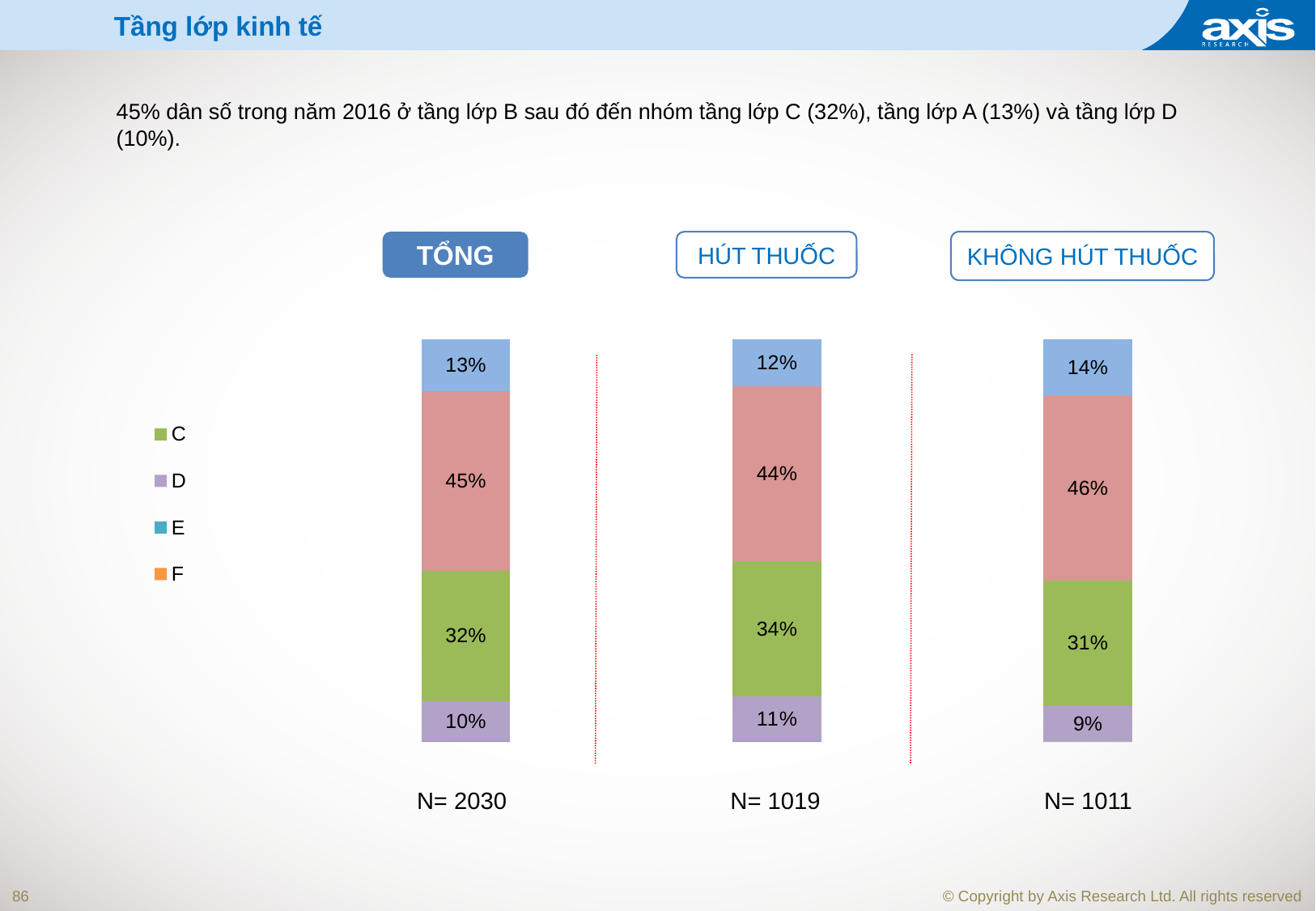
What is the difference between the pink segment in the KHÔNG HÚT THUỐC bar and the pink segment in the HÚT THUỐC bar? 2 percentage points How many entries does the legend list? 4 In the KHÔNG HÚT THUỐC bar, what is the value of the top blue segment? 14% How many stacked bars are shown on the slide? 3 In the KHÔNG HÚT THUỐC bar, what is the value of the pink segment? 46% What is the sample size shown under the HÚT THUỐC bar? N= 1019 Which segment is the largest in the TỔNG bar? The pink segment, 45% In the HÚT THUỐC bar, what is the value of the purple D segment? 11% Is the green C segment larger in the HÚT THUỐC bar or the KHÔNG HÚT THUỐC bar? HÚT THUỐC In the TỔNG bar, what is the value of the green C segment? 32% Which segment is the smallest in the KHÔNG HÚT THUỐC bar? The purple D segment, 9% What kind of chart is shown on the slide? Stacked bar chart